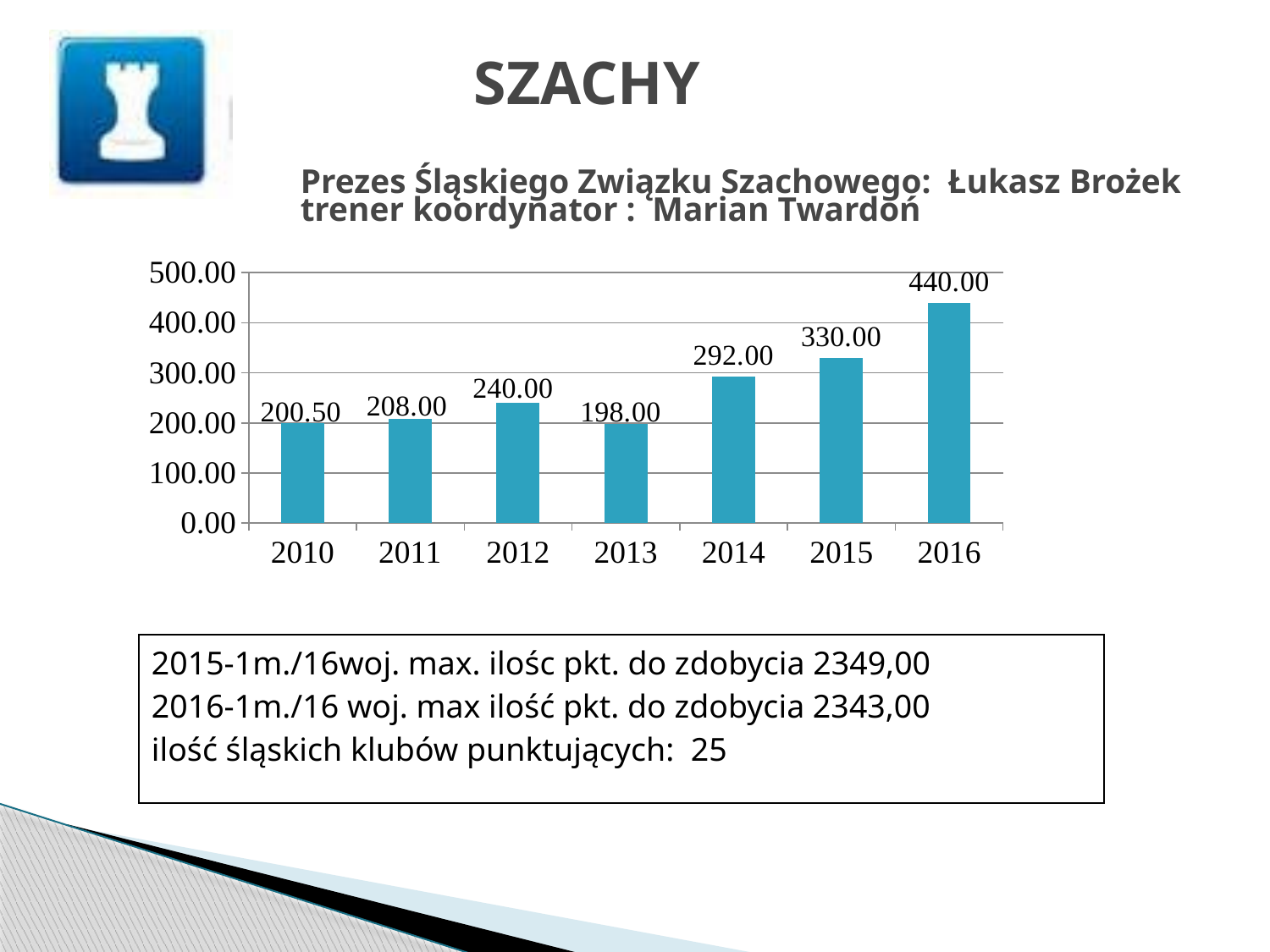
Which year has the highest value? 2016 What is the value for 2010? 200.50 What kind of chart is shown on the slide? bar chart What is the value for 2014? 292.00 How many years are shown on the x axis? 7 Is the value for 2015 greater or less than 300.00? greater What is the value for 2013? 198.00 Which year has the lowest value? 2013 What is the value for 2016? 440.00 What is the difference between the values for 2016 and 2015? 110.00 Which is larger, the value for 2014 or the value for 2012? 2014 What is the difference between the values for 2012 and 2011? 32.00